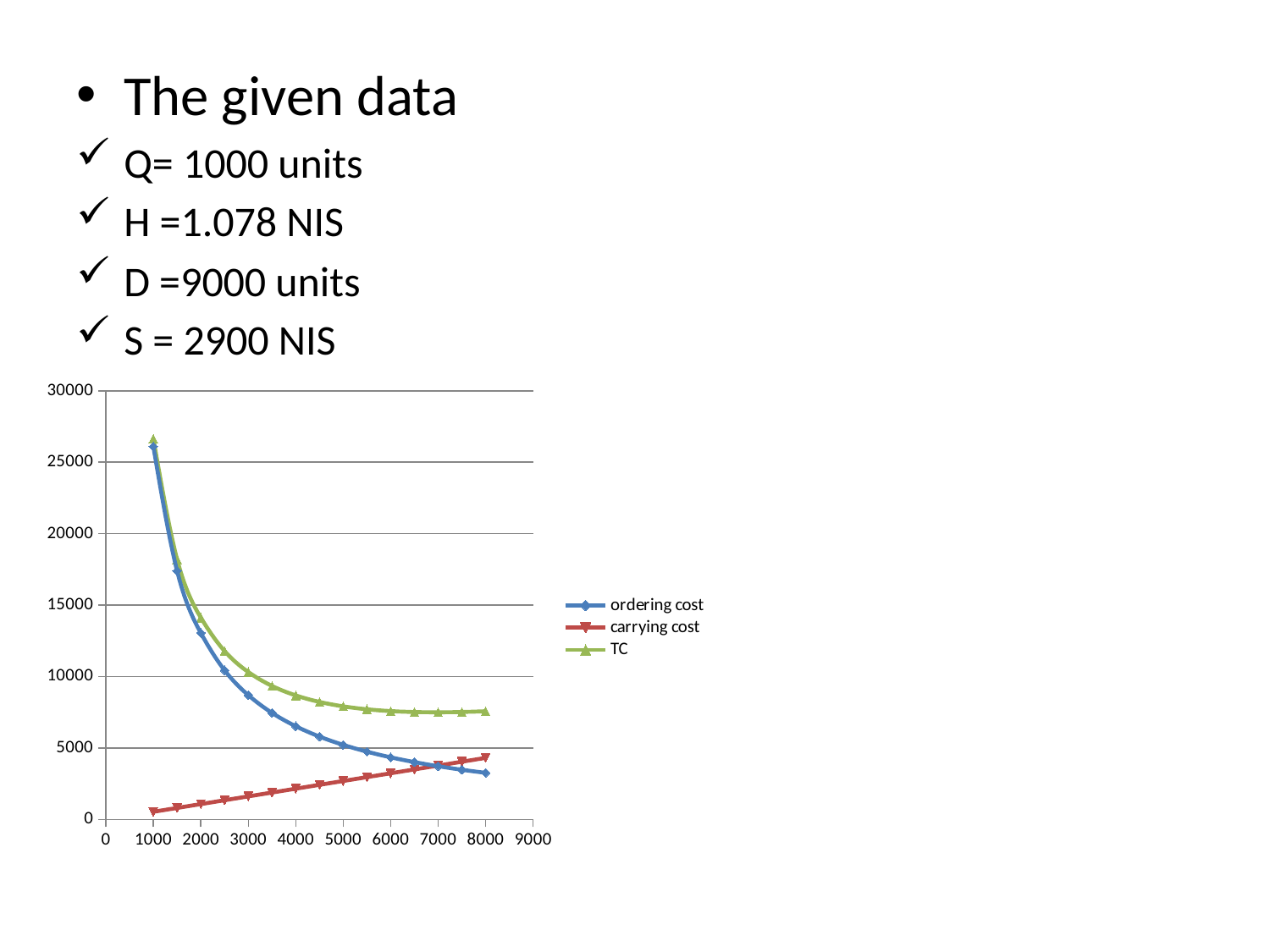
Does the carrying cost series rise or fall as the x-axis value increases? rise Is the carrying cost at x = 1000 greater or less than 5000? less What are the three series named in the chart's legend? ordering cost, carrying cost, TC Does the ordering cost series rise or fall as the x-axis value increases? fall At x = 8000, which is larger: carrying cost or ordering cost? carrying cost How many series does the chart's legend list? 3 Is the ordering cost at x = 1000 greater or less than 25000? greater Is the TC value at x = 8000 greater or less than 10000? less Which colour is used for the TC series in the chart? green At x = 1000, which is larger: ordering cost or carrying cost? ordering cost What kind of chart is shown on the slide? line chart